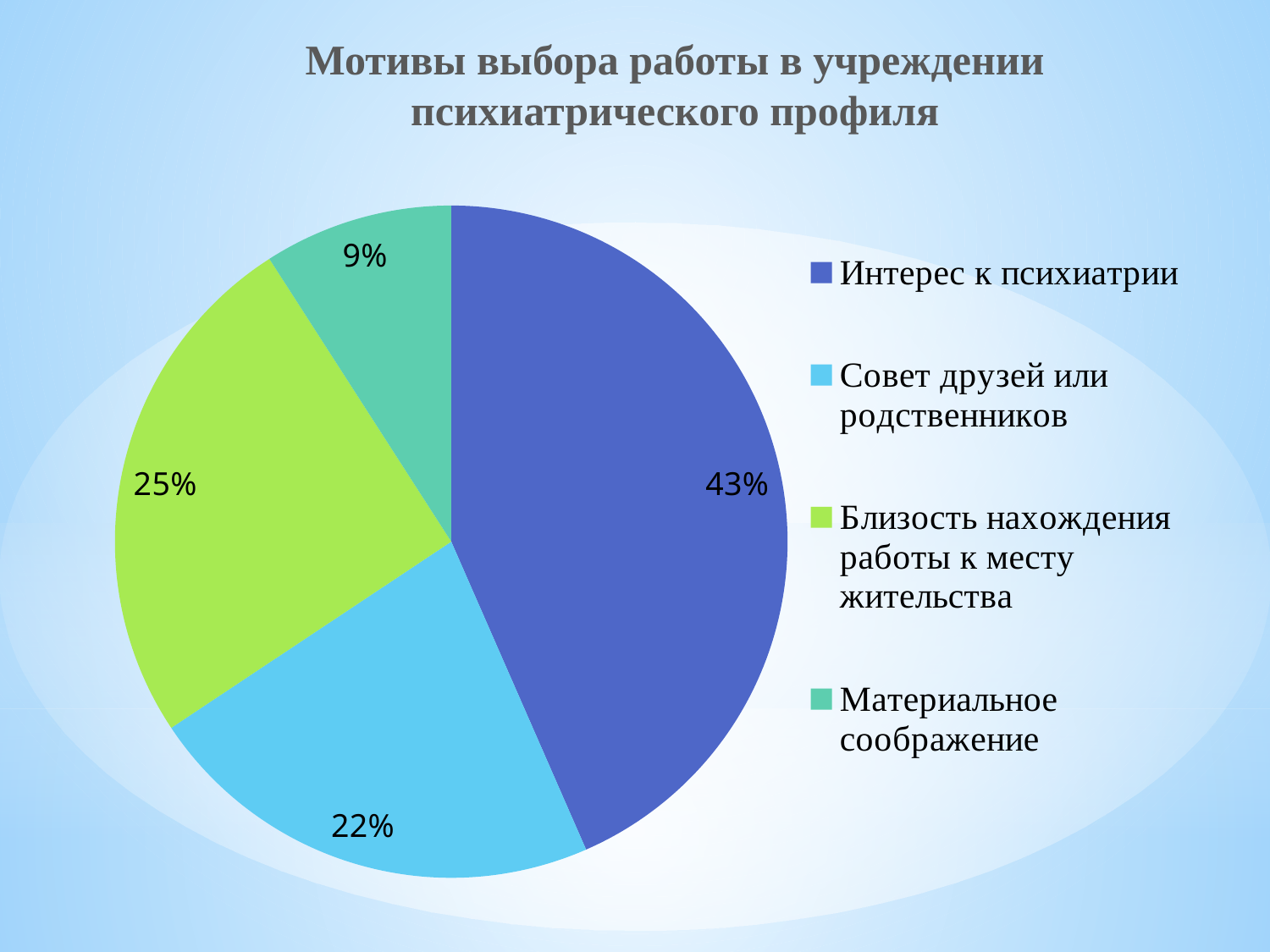
How many categories does the pie chart have? 4 What is the difference between the shares for "Интерес к психиатрии" and "Близость нахождения работы к месту жительства"? 18% Which category has the smallest share of the pie? Материальное соображение Which category has the largest share of the pie? Интерес к психиатрии Which is larger: the share for "Совет друзей или родственников" or for "Близость нахождения работы к месту жительства"? Близость нахождения работы к месту жительства What type of chart is shown on the slide? Pie chart What is the value for "Совет друзей или родственников"? 22% What colour is the slice for "Материальное соображение"? Teal (green-blue) What is the value for "Материальное соображение"? 9% What is the value for "Интерес к психиатрии"? 43% What is the value for "Близость нахождения работы к месту жительства"? 25% What is the title of the chart? Мотивы выбора работы в учреждении психиатрического профиля